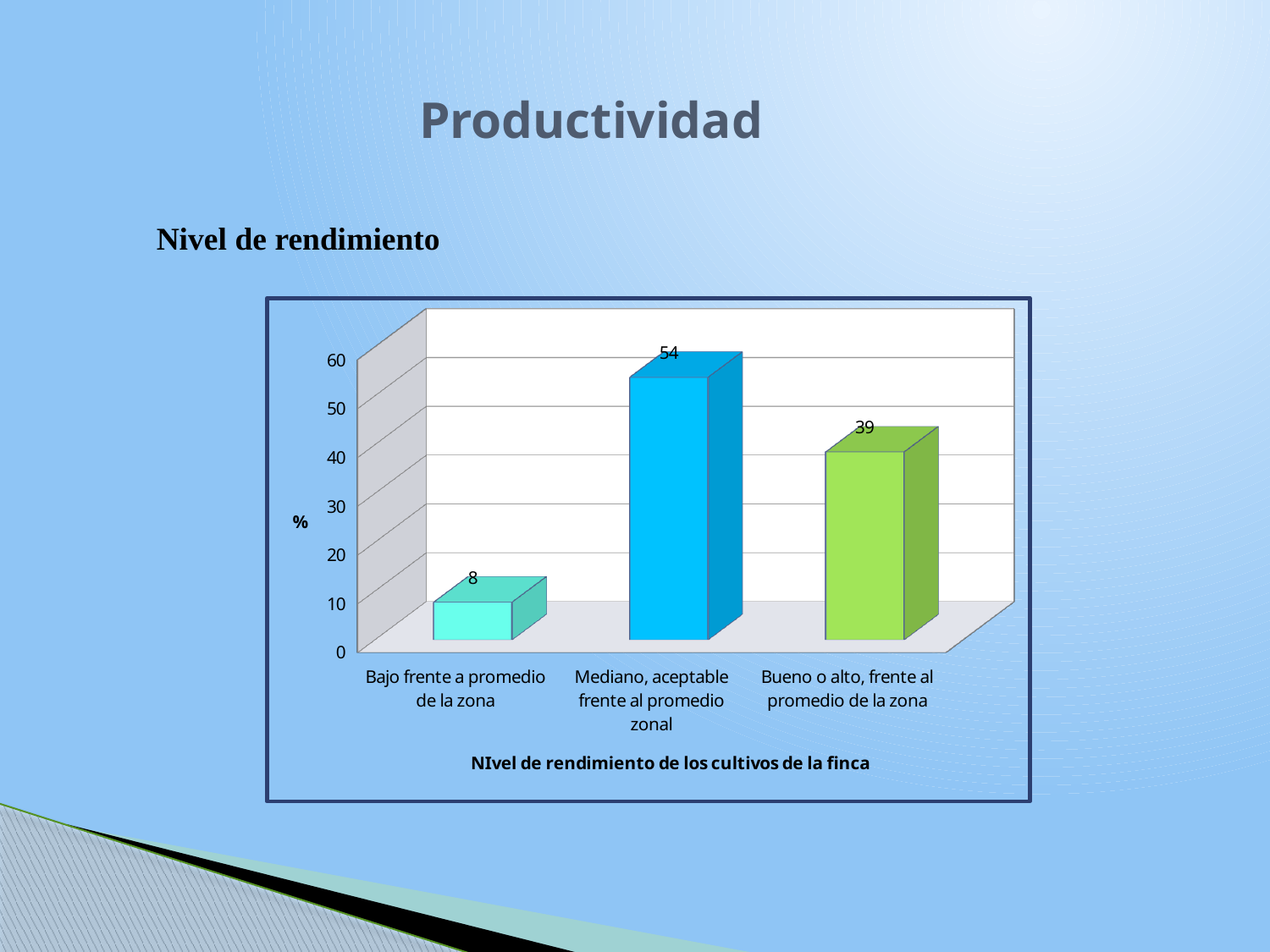
What is the difference between the values for "Mediano, aceptable frente al promedio zonal" and "Bueno o alto, frente al promedio de la zona"? 15 Is the value for "Mediano, aceptable frente al promedio zonal" greater or less than 50? greater What is the value for "Bueno o alto, frente al promedio de la zona"? 39 What is the value for "Mediano, aceptable frente al promedio zonal"? 54 Which category has the highest value? Mediano, aceptable frente al promedio zonal What is the difference between the values for "Bueno o alto, frente al promedio de la zona" and "Bajo frente a promedio de la zona"? 31 How many categories are shown on the x axis? 3 What kind of chart is shown on the slide? bar chart What is the value for "Bajo frente a promedio de la zona"? 8 What is the x-axis title of the chart? NIvel de rendimiento de los cultivos de la finca Which category has the lowest value? Bajo frente a promedio de la zona Which is larger, the value for "Bueno o alto, frente al promedio de la zona" or the value for "Bajo frente a promedio de la zona"? Bueno o alto, frente al promedio de la zona